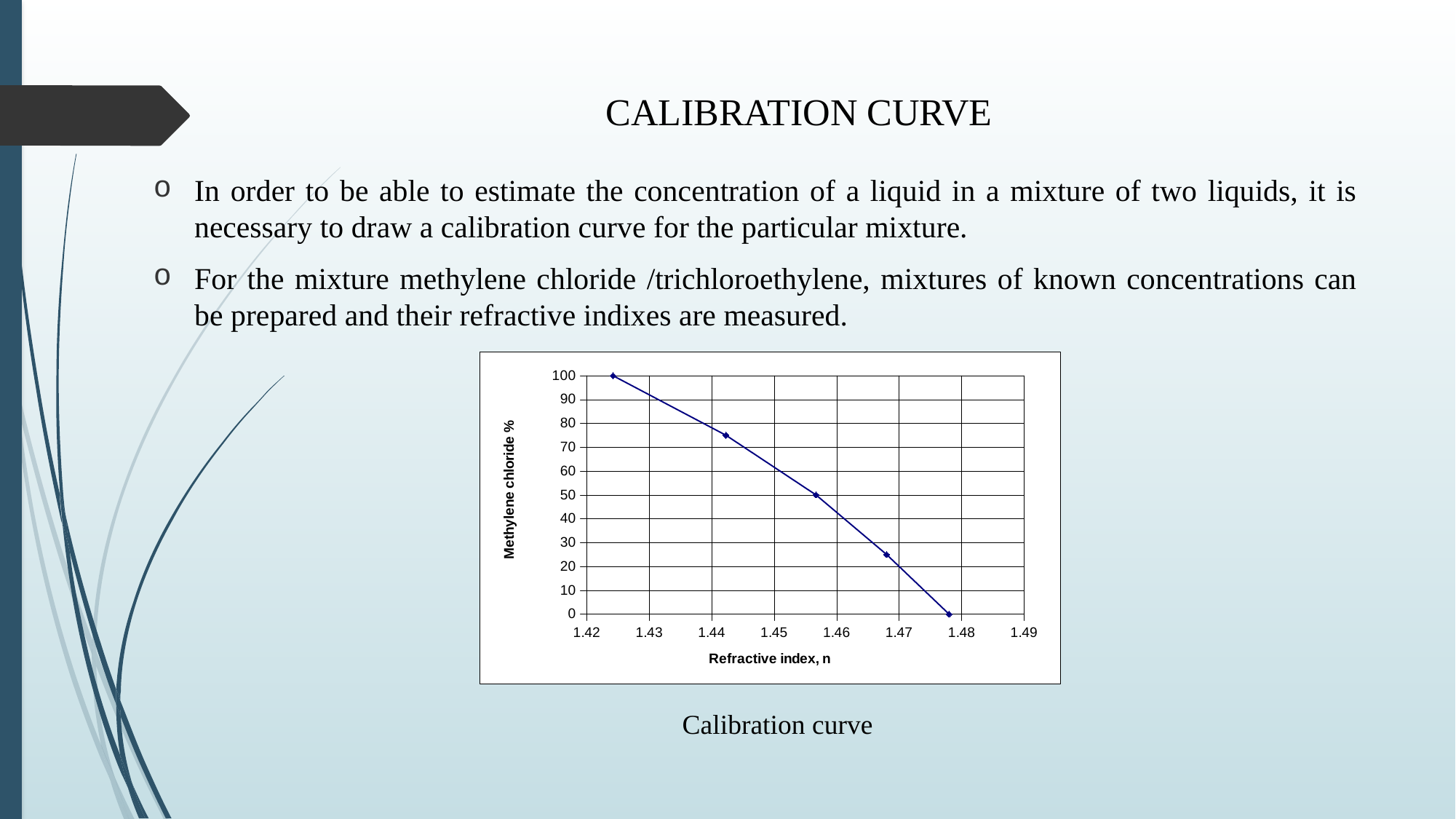
What kind of chart is shown on the slide? Line chart Which has the higher methylene chloride %, the leftmost point or the rightmost point on the curve? The leftmost point How many data points are plotted on the calibration curve? 5 As the refractive index increases along the x axis, does the methylene chloride % rise or fall? Fall Is the methylene chloride % of the fourth data point from the left greater or less than 30? less What is the label of the y axis of the chart? Methylene chloride % Is the refractive index of the point at 0% methylene chloride greater or less than 1.47? greater What is the lowest methylene chloride % value plotted on the chart? 0 What is the highest methylene chloride % value plotted on the chart? 100 What is the label of the x axis of the chart? Refractive index, n Is the refractive index of the point at 100% methylene chloride greater or less than 1.43? less